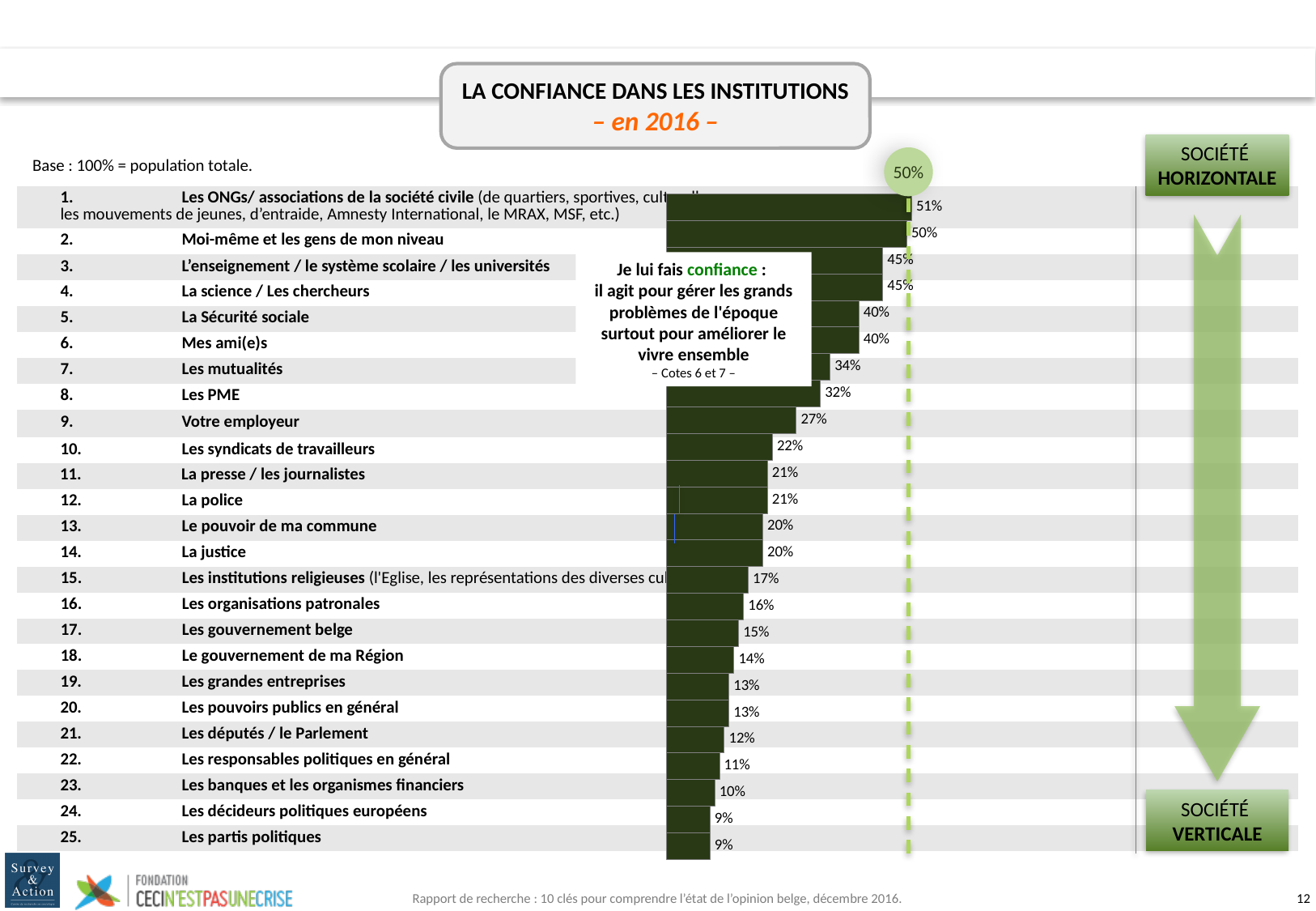
Which has a higher value: 'Les mutualités' or 'La police'? Les mutualités What kind of chart is shown on the slide? Bar chart What is the difference between the value for 'Les ONGs/ associations de la société civile' and the value for 'Les partis politiques'? 42% Do the values rise or fall going from the top of the chart to the bottom? Fall What is the value for 'Les banques et les organismes financiers'? 10% What percentage of respondents trust 'Les ONGs/ associations de la société civile'? 51% Which institution has the highest trust percentage on the chart? Les ONGs/ associations de la société civile What is the value shown for 'La Sécurité sociale'? 40% How many institutions are listed on the chart? 25 Is the value for 'Votre employeur' greater or less than 50%? less What is the lowest percentage shown on the chart? 9% What percentage is shown for 'Les PME'? 32%